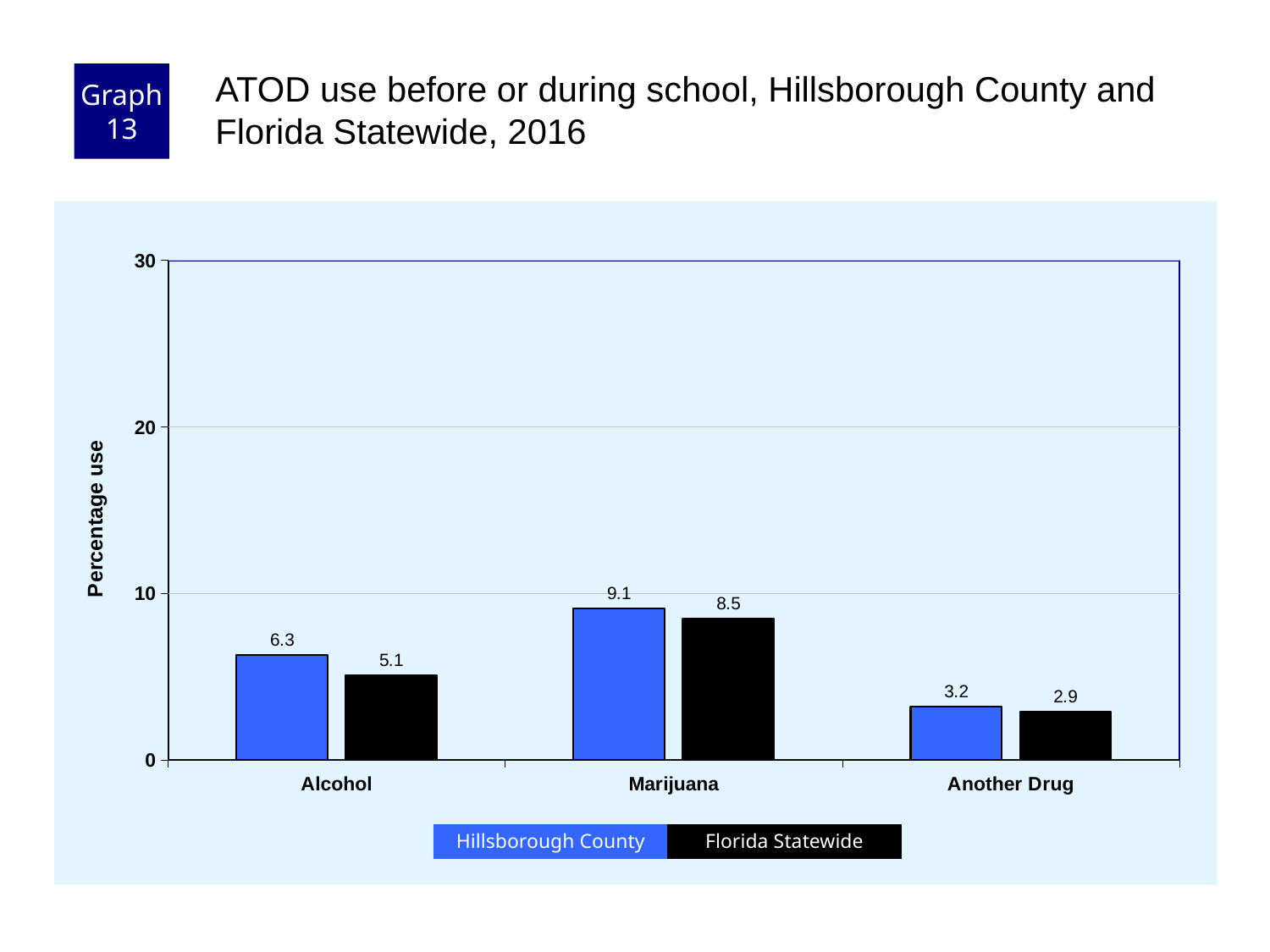
How many categories are shown on the x axis? 3 Which category has the lowest Florida Statewide value? Another Drug What is the Hillsborough County value for Alcohol? 6.3 What is the Florida Statewide value for Marijuana? 8.5 Which category has the highest Hillsborough County value? Marijuana Which is larger for Marijuana: Hillsborough County or Florida Statewide? Hillsborough County What is the difference between the Hillsborough County and Florida Statewide values for Alcohol? 1.2 Is the Hillsborough County value for Marijuana greater or less than 10? less What is the label of the y axis? Percentage use What kind of chart is shown on the slide? bar chart What is the Florida Statewide value for Another Drug? 2.9 How many series does the legend list? 2